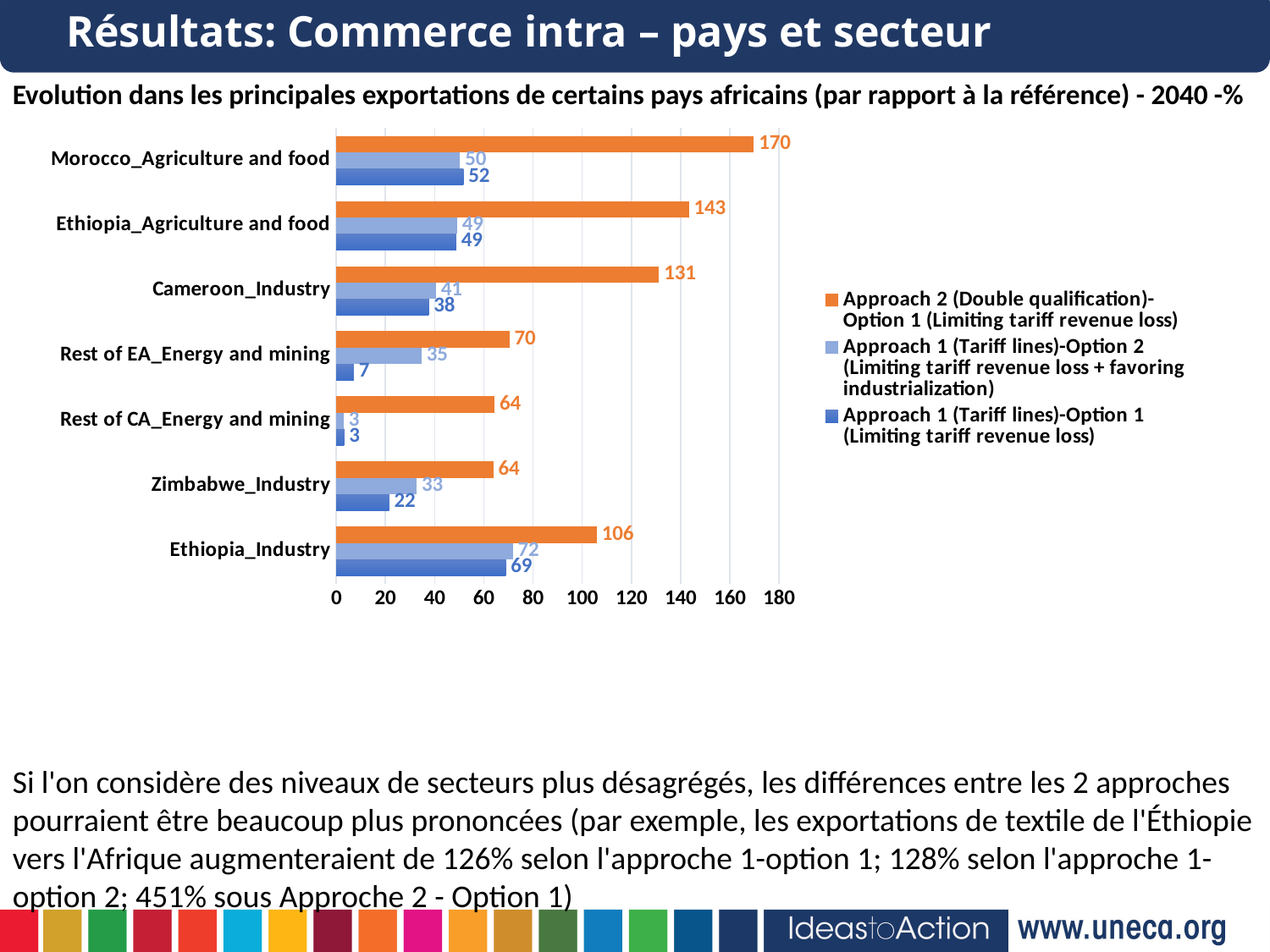
How many categories are plotted on the chart? 7 Which category has the highest value under Approach 2 (Double qualification)-Option 1? Morocco_Agriculture and food How many series does the legend list? 3 What is the value for Ethiopia_Industry under Approach 1 (Tariff lines)-Option 2? 72 Is the Approach 2 value for Ethiopia_Agriculture and food greater or less than 120? greater Which series is shown in orange in the legend? Approach 2 (Double qualification)-Option 1 (Limiting tariff revenue loss) Which is larger for Zimbabwe_Industry: the Approach 1-Option 2 value or the Approach 1-Option 1 value? Approach 1 (Tariff lines)-Option 2 What is the value for Morocco_Agriculture and food under Approach 2 (Double qualification)-Option 1? 170 What type of chart is shown on the slide? bar chart Which category has the lowest value under Approach 1 (Tariff lines)-Option 1? Rest of CA_Energy and mining What is the value for Rest of EA_Energy and mining under Approach 1 (Tariff lines)-Option 1? 7 What is the difference between the Approach 2 value and the Approach 1-Option 1 value for Cameroon_Industry? 93